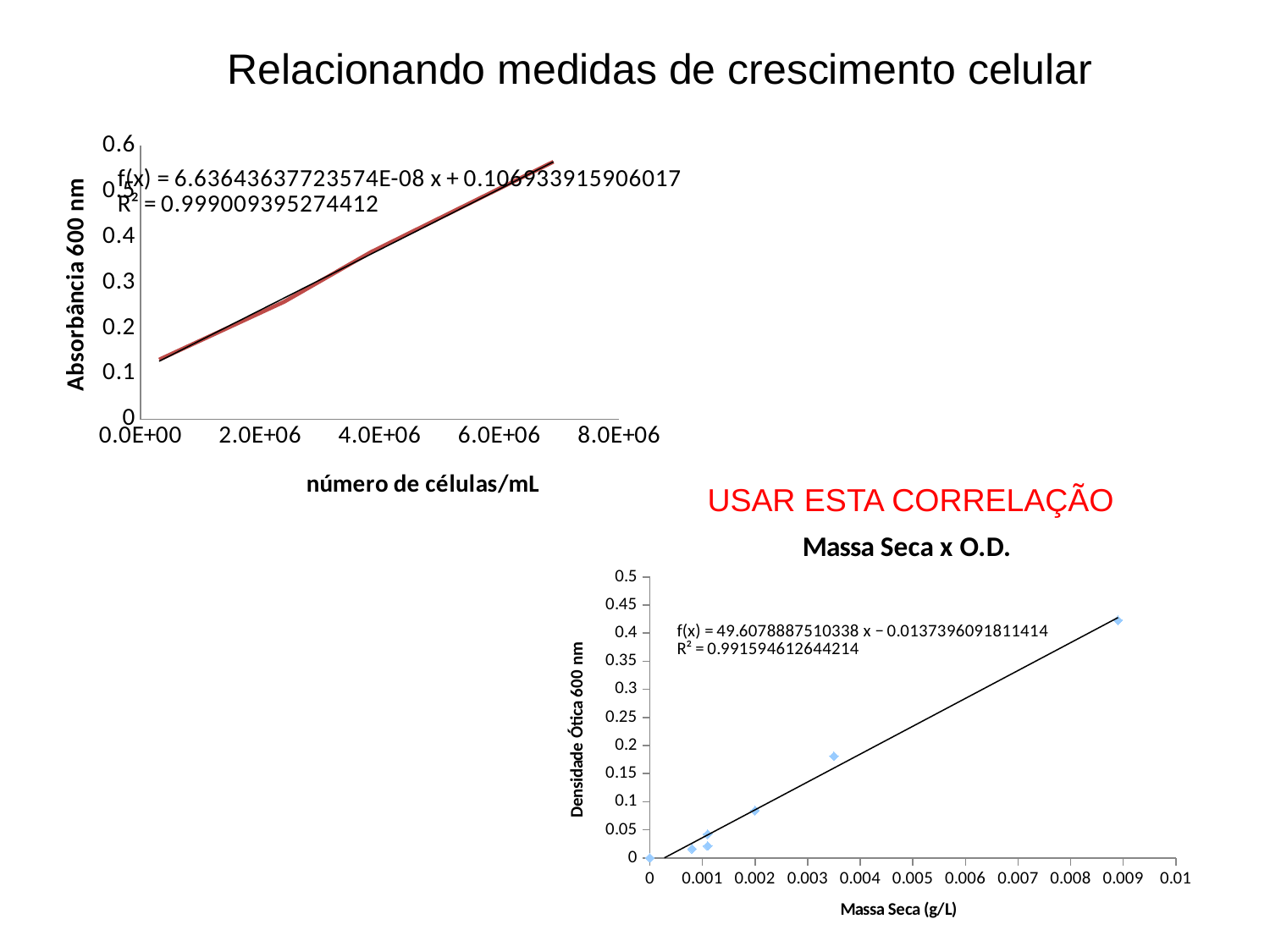
In the 'Massa Seca x O.D.' chart, is the Densidade Ótica of the point at about 0.009 g/L greater or less than 0.4? greater In the upper-left chart (Absorbância 600 nm vs número de células/mL), what is the highest value shown on the y axis? 0.6 In the upper-left chart (Absorbância 600 nm vs número de células/mL), is the absorbance at about 6.0E+06 cells/mL greater or less than 0.4? greater In the 'Massa Seca x O.D.' chart, is the Densidade Ótica of the point at about 0.0035 g/L greater or less than 0.2? less In the upper-left chart (Absorbância 600 nm vs número de células/mL), what is the R² value shown? 0.999009395274412 In the 'Massa Seca x O.D.' chart, do the plotted values rise or fall as Massa Seca increases? rise In the upper-left chart (Absorbância 600 nm vs número de células/mL), does absorbance rise or fall as the number of cells increases? rise In the 'Massa Seca x O.D.' chart, what is the R² value shown? 0.991594612644214 What type of chart is the 'Massa Seca x O.D.' chart? scatter chart In the 'Massa Seca x O.D.' chart, what is the label of the x axis? Massa Seca (g/L) In the 'Massa Seca x O.D.' chart, what is the slope of the fitted line f(x)? 49.6078887510338